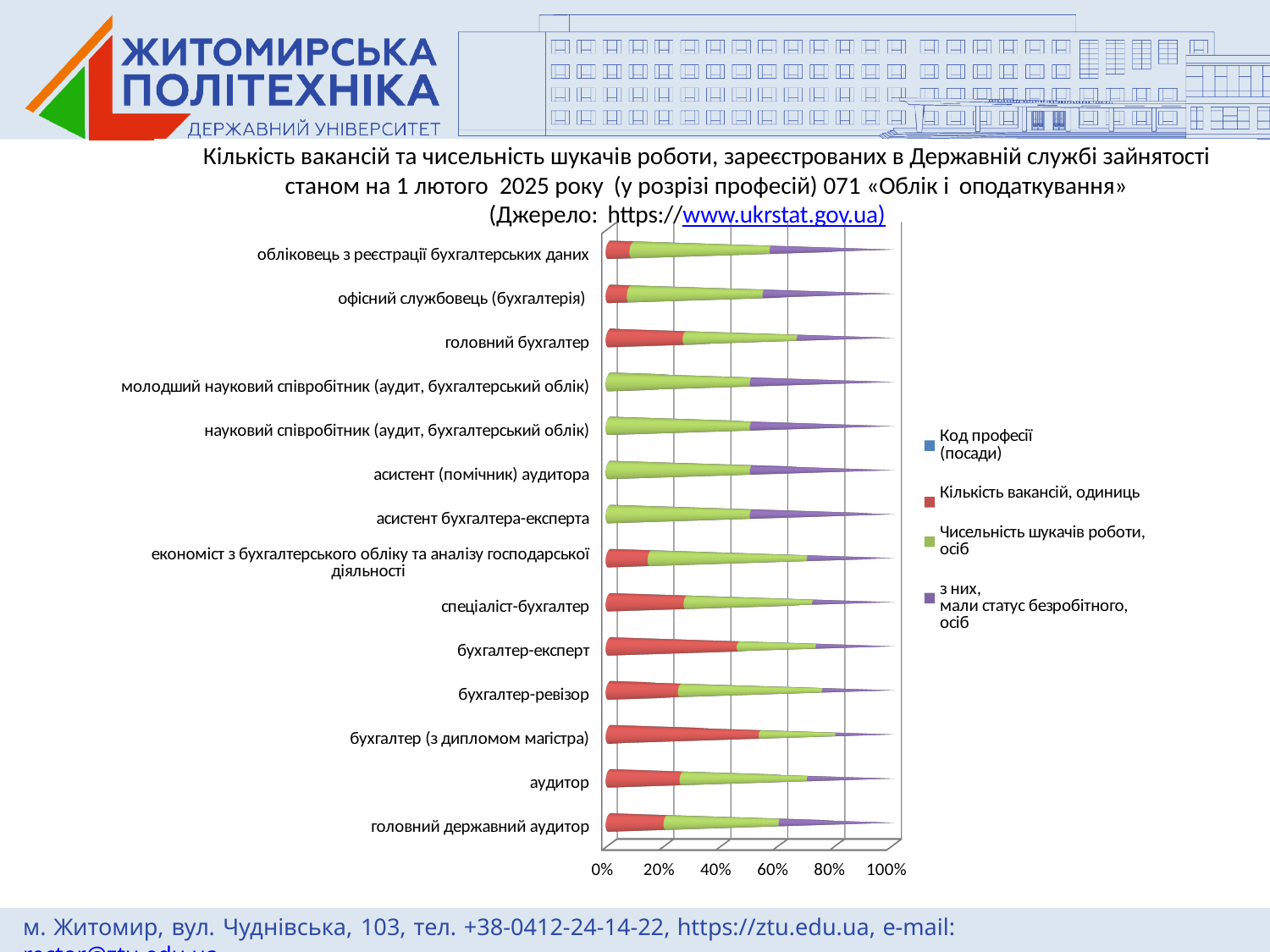
Is the share for Кількість вакансій, одиниць for бухгалтер (з дипломом магістра) greater or less than 80%? less Which profession has the largest share for Кількість вакансій, одиниць? бухгалтер (з дипломом магістра) How many professions (categories) are listed on the vertical axis of the chart? 14 Which has the larger share for Кількість вакансій, одиниць: головний бухгалтер or асистент (помічник) аудитора? головний бухгалтер Which legend entry is shown in green? Чисельність шукачів роботи, осіб Which has the larger share for Кількість вакансій, одиниць: бухгалтер (з дипломом магістра) or науковий співробітник (аудит, бухгалтерський облік)? бухгалтер (з дипломом магістра) Is the share for Чисельність шукачів роботи, осіб for молодший науковий співробітник (аудит, бухгалтерський облік) greater or less than 40%? greater What kind of chart is shown on the slide? bar chart Which legend entry is shown in red? Кількість вакансій, одиниць Is the share for Кількість вакансій, одиниць for обліковець з реєстрації бухгалтерських даних greater or less than 20%? less How many series does the chart legend list? 4